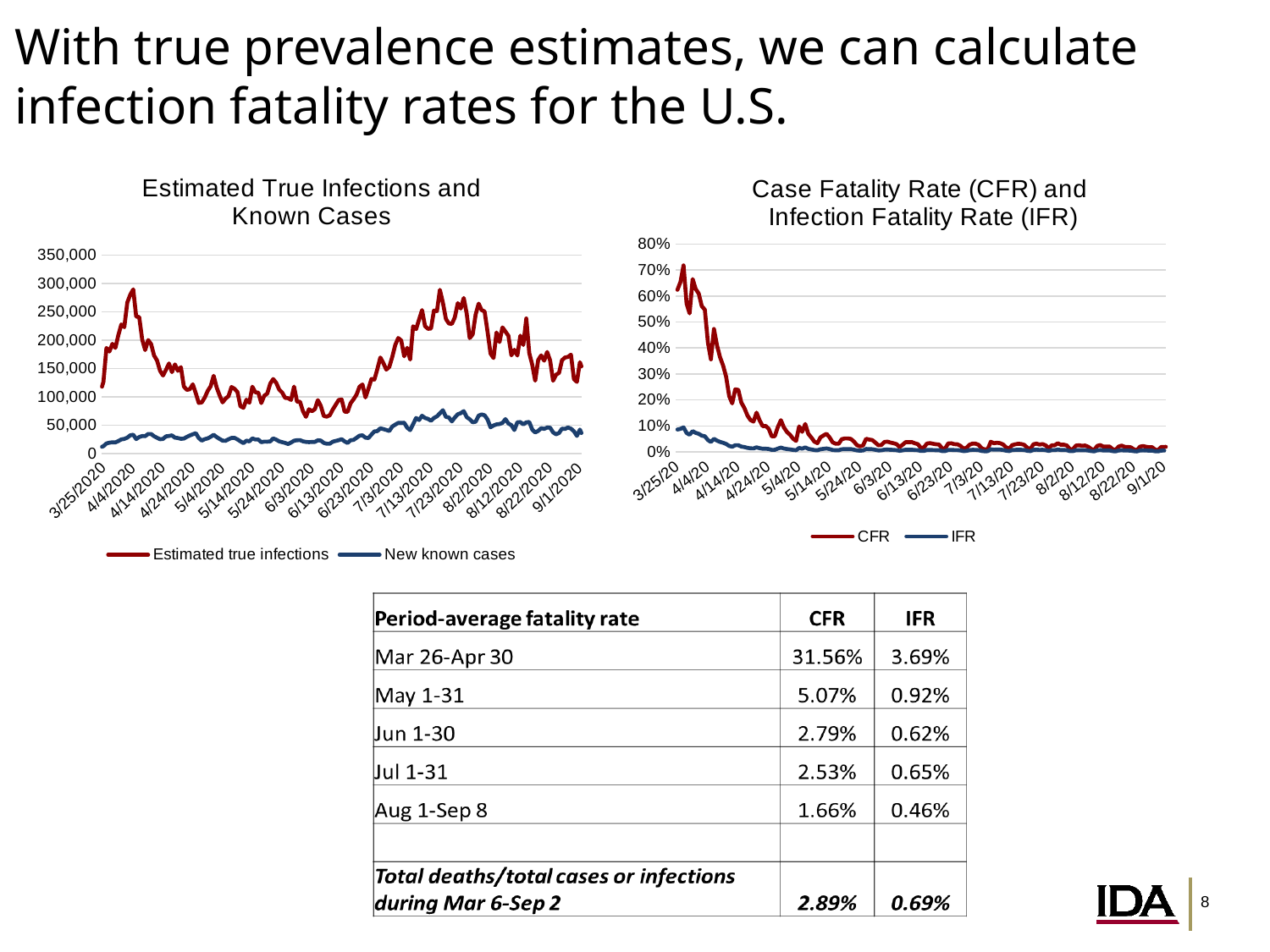
What kind of chart is the chart titled "Estimated True Infections and Known Cases"? line chart In the chart titled "Estimated True Infections and Known Cases", what colour is the line for New known cases? blue In the chart titled "Case Fatality Rate (CFR) and Infection Fatality Rate (IFR)", does the CFR line generally rise or fall from 3/25/20 to 9/1/20? fall In the chart titled "Case Fatality Rate (CFR) and Infection Fatality Rate (IFR)", which series is higher on 4/4/20, CFR or IFR? CFR In the chart titled "Case Fatality Rate (CFR) and Infection Fatality Rate (IFR)", is the IFR value on 3/25/20 greater or less than 20%? less In the chart titled "Case Fatality Rate (CFR) and Infection Fatality Rate (IFR)", is the CFR value on 3/25/20 greater or less than 50%? greater In the chart titled "Estimated True Infections and Known Cases", which series reaches the highest value? Estimated true infections What kind of chart is the chart titled "Case Fatality Rate (CFR) and Infection Fatality Rate (IFR)"? line chart In the chart titled "Estimated True Infections and Known Cases", is the peak value of Estimated true infections around 4/4/2020 greater or less than 250,000? greater In the chart titled "Case Fatality Rate (CFR) and Infection Fatality Rate (IFR)", how many series does the legend list? 2 In the chart titled "Estimated True Infections and Known Cases", how many series does the legend list? 2